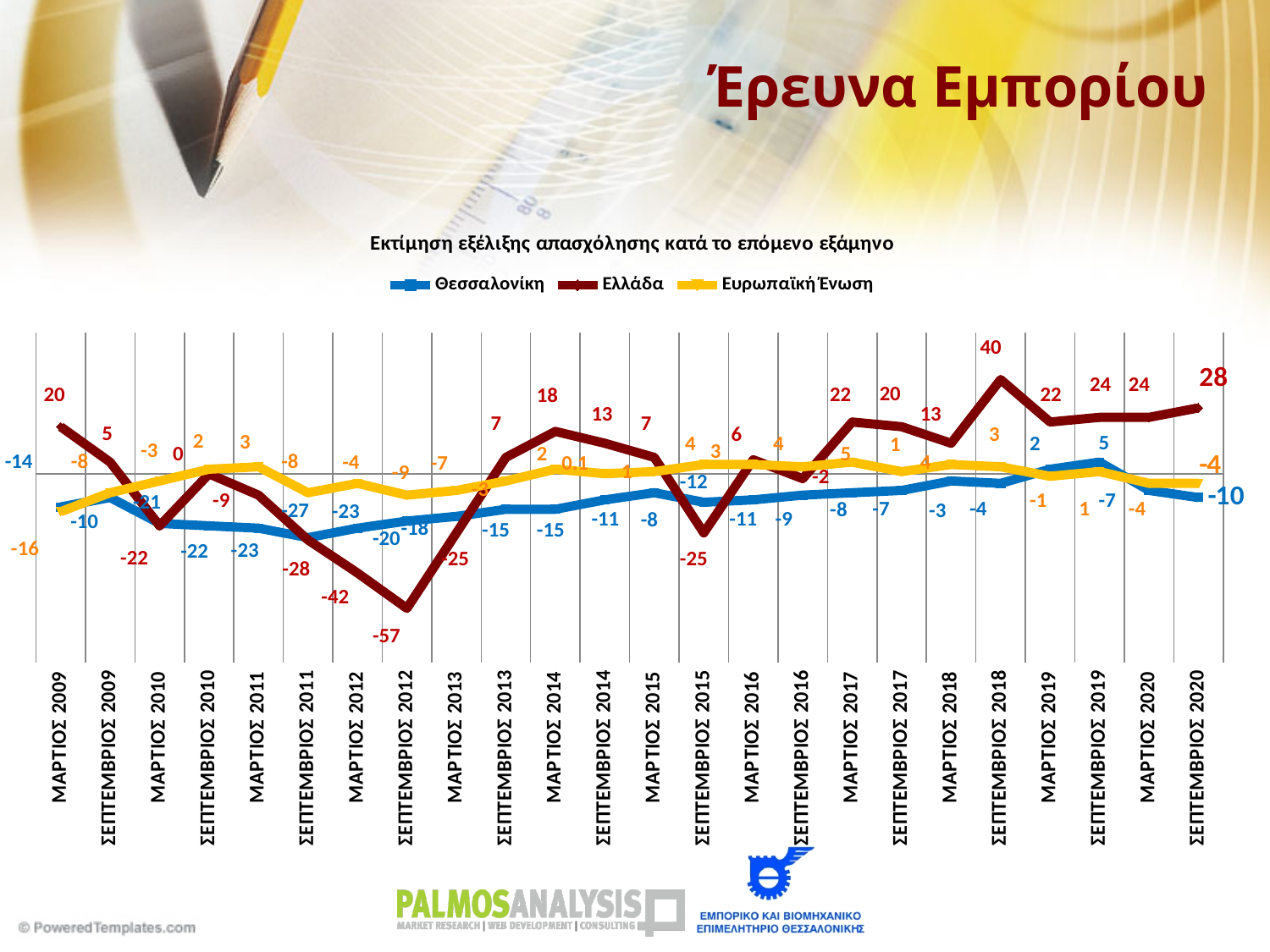
In which period does the Ελλάδα series reach its highest value? ΣΕΠΤΕΜΒΡΙΟΣ 2018 What is the lowest value of the Ελλάδα series? -57 In which period does the Θεσσαλονίκη series reach its lowest value? ΣΕΠΤΕΜΒΡΙΟΣ 2011 What is the value for Ελλάδα in ΜΑΡΤΙΟΣ 2014? 18 What is the value for Ελλάδα in ΣΕΠΤΕΜΒΡΙΟΣ 2020? 28 How many series does the legend list? 3 What type of chart is shown on the slide? line chart What is the difference between the Ελλάδα and Θεσσαλονίκη values in ΣΕΠΤΕΜΒΡΙΟΣ 2020? 38 What is the value for Ευρωπαϊκή Ένωση in ΣΕΠΤΕΜΒΡΙΟΣ 2020? -4 What is the value for Θεσσαλονίκη in ΣΕΠΤΕΜΒΡΙΟΣ 2020? -10 How many time points are plotted along the x axis? 24 In ΣΕΠΤΕΜΒΡΙΟΣ 2018, which series has the higher value, Ελλάδα or Θεσσαλονίκη? Ελλάδα